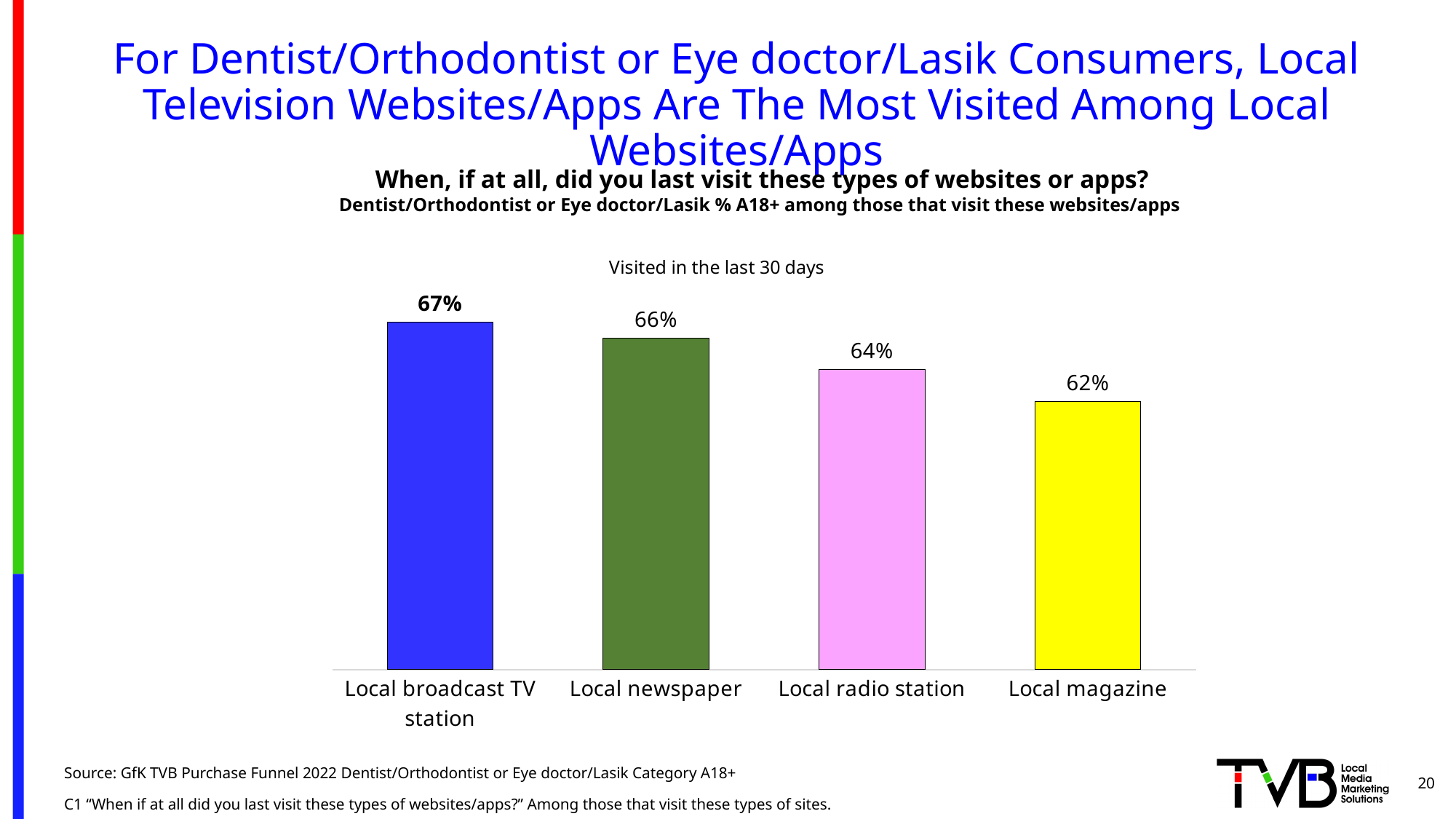
What is the difference in percentage points between Local broadcast TV station and Local magazine? 5 What is the value shown for Local radio station? 64% Which category has the highest value in the chart? Local broadcast TV station What percentage of Dentist/Orthodontist or Eye doctor/Lasik consumers visited a local broadcast TV station website/app in the last 30 days? 67% How many categories are shown in the chart? 4 What is the value shown for Local magazine? 62% What is the difference in percentage points between Local newspaper and Local radio station? 2 Which category has the lowest value in the chart? Local magazine Do the values rise or fall moving from left to right across the categories? Fall What is the label shown above the chart describing the time period measured? Visited in the last 30 days What is the value shown for Local newspaper? 66% What type of chart is shown on the slide? Bar chart